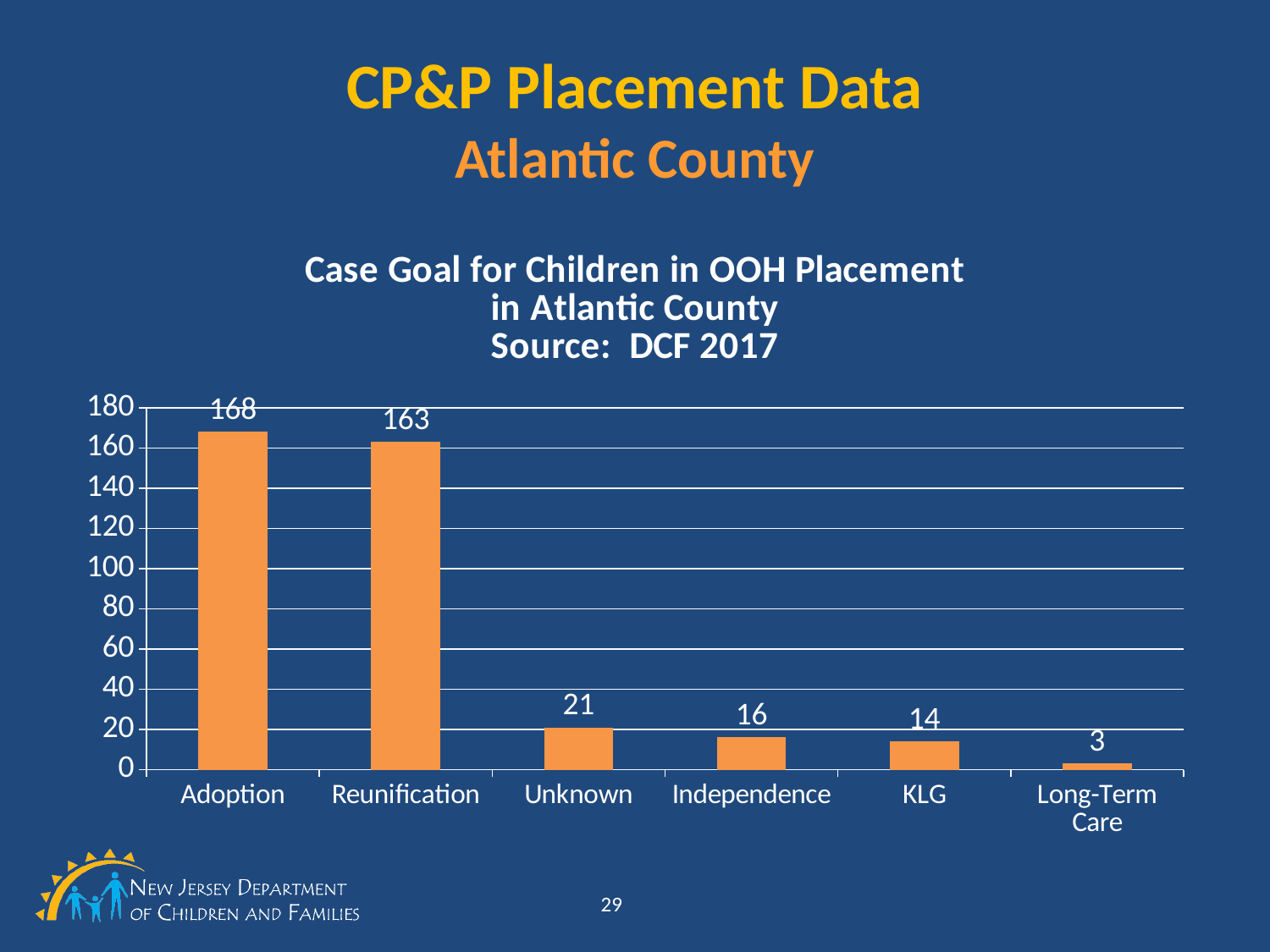
What is the value for KLG? 14 What is the difference between the values for Adoption and Reunification? 5 Which case goal has the highest value? Adoption Which case goal has the lowest value? Long-Term Care What is the value for Reunification? 163 Which is larger, the value for Unknown or the value for Independence? Unknown What is the value for Adoption? 168 What is the value for Unknown? 21 How many case goal categories are shown on the chart? 6 What is the value for Long-Term Care? 3 What is the source cited in the chart title? DCF 2017 What kind of chart is shown on the slide? Bar chart